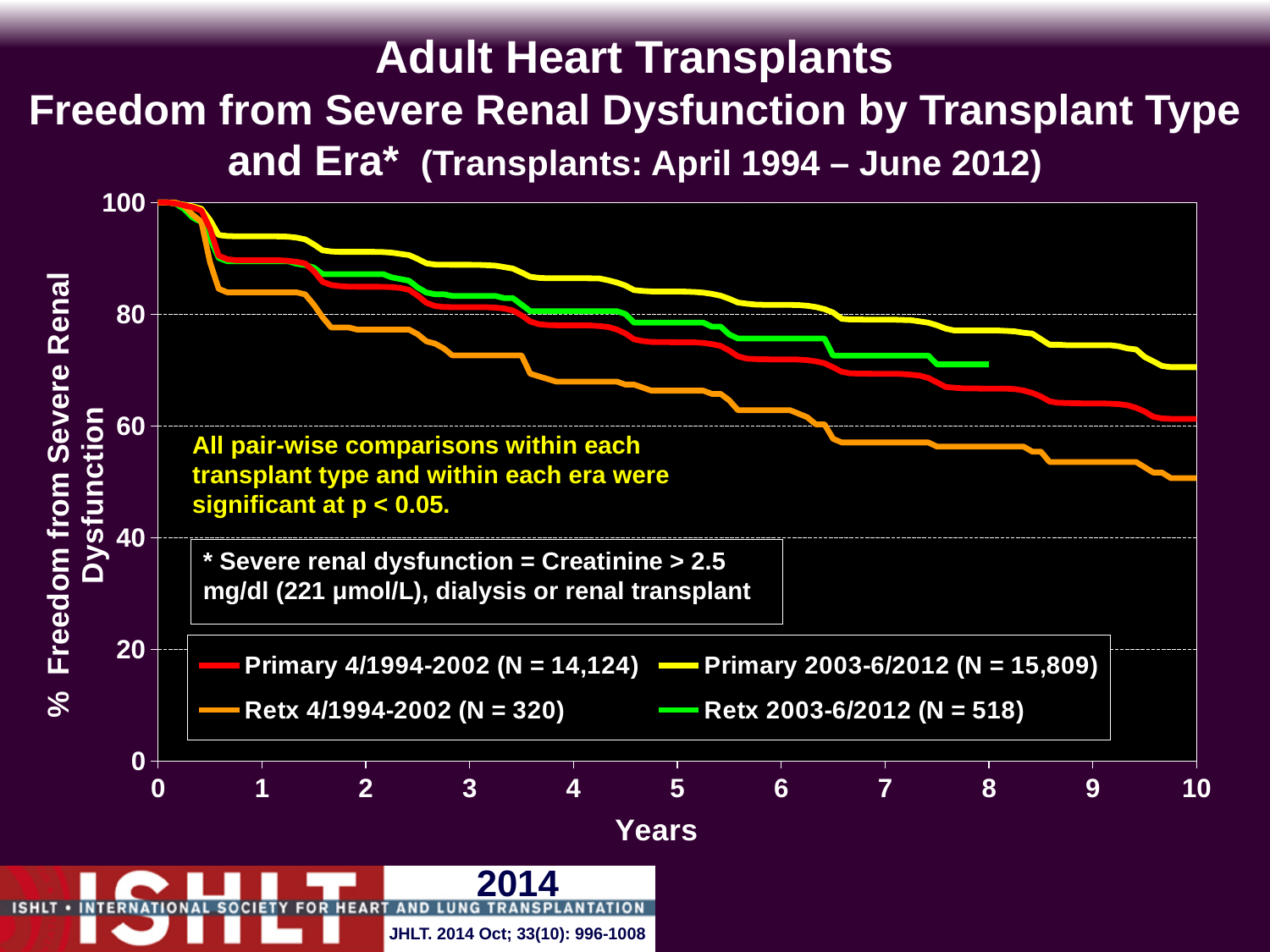
What kind of chart is shown on the slide? line chart What colour is the line for Primary 4/1994-2002? red Is the value for Retx 4/1994-2002 at 10 years greater or less than 60? less Which series has the highest freedom from severe renal dysfunction across the years shown? Primary 2003-6/2012 (N = 15,809) At 3 years, which is larger: the value for Primary 4/1994-2002 or the value for Retx 4/1994-2002? Primary 4/1994-2002 What is the N shown in the legend for Retx 2003-6/2012? 518 Is the value for Retx 2003-6/2012 at 8 years greater or less than 60? greater Do the values for Primary 2003-6/2012 rise or fall as years increase? fall Which series has the lowest freedom from severe renal dysfunction across the years shown? Retx 4/1994-2002 (N = 320) At 5 years, which is larger: the value for Primary 2003-6/2012 or the value for Retx 4/1994-2002? Primary 2003-6/2012 Is the value for Primary 2003-6/2012 at 10 years greater or less than 60? greater How many series does the legend list? 4